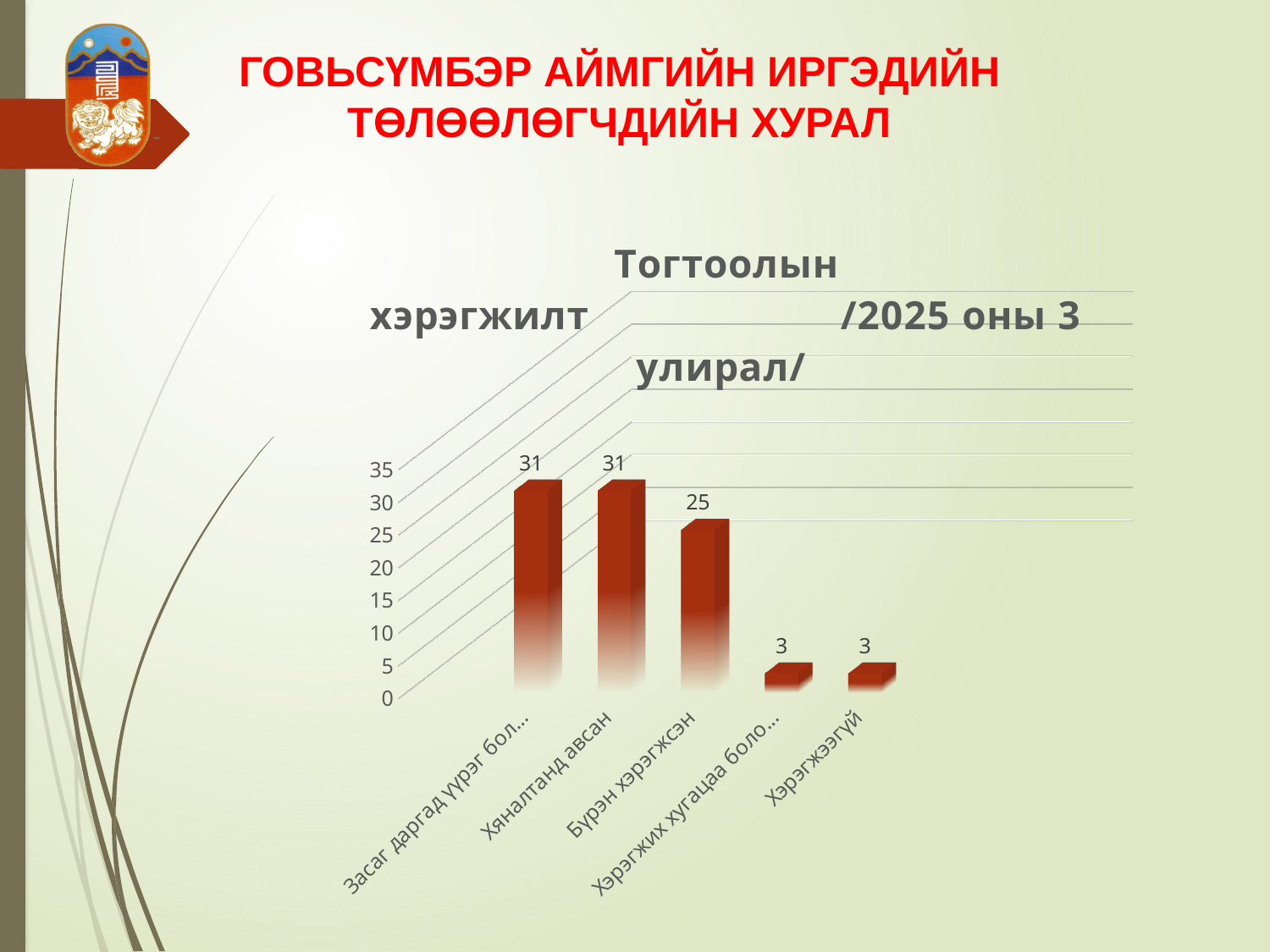
What type of chart is shown on the slide? bar chart What is the title of the chart? Тогтоолын хэрэгжилт /2025 оны 3 улирал/ Is the value for "Бүрэн хэрэгжсэн" greater or less than 20? greater What is the value for "Бүрэн хэрэгжсэн"? 25 What is the difference between the values for "Бүрэн хэрэгжсэн" and "Хэрэгжээгүй"? 22 How many categories are plotted in the chart? 5 What is the value for "Хяналтанд авсан"? 31 Which is larger, the value for "Хяналтанд авсан" or the value for "Бүрэн хэрэгжсэн"? Хяналтанд авсан What is the value of the first bar on the left ("Засаг даргад үүрэг бол...")? 31 What is the difference between the values for "Хяналтанд авсан" and "Бүрэн хэрэгжсэн"? 6 What is the value for "Хэрэгжээгүй"? 3 Do the bar values generally rise or fall from left to right across the categories? fall